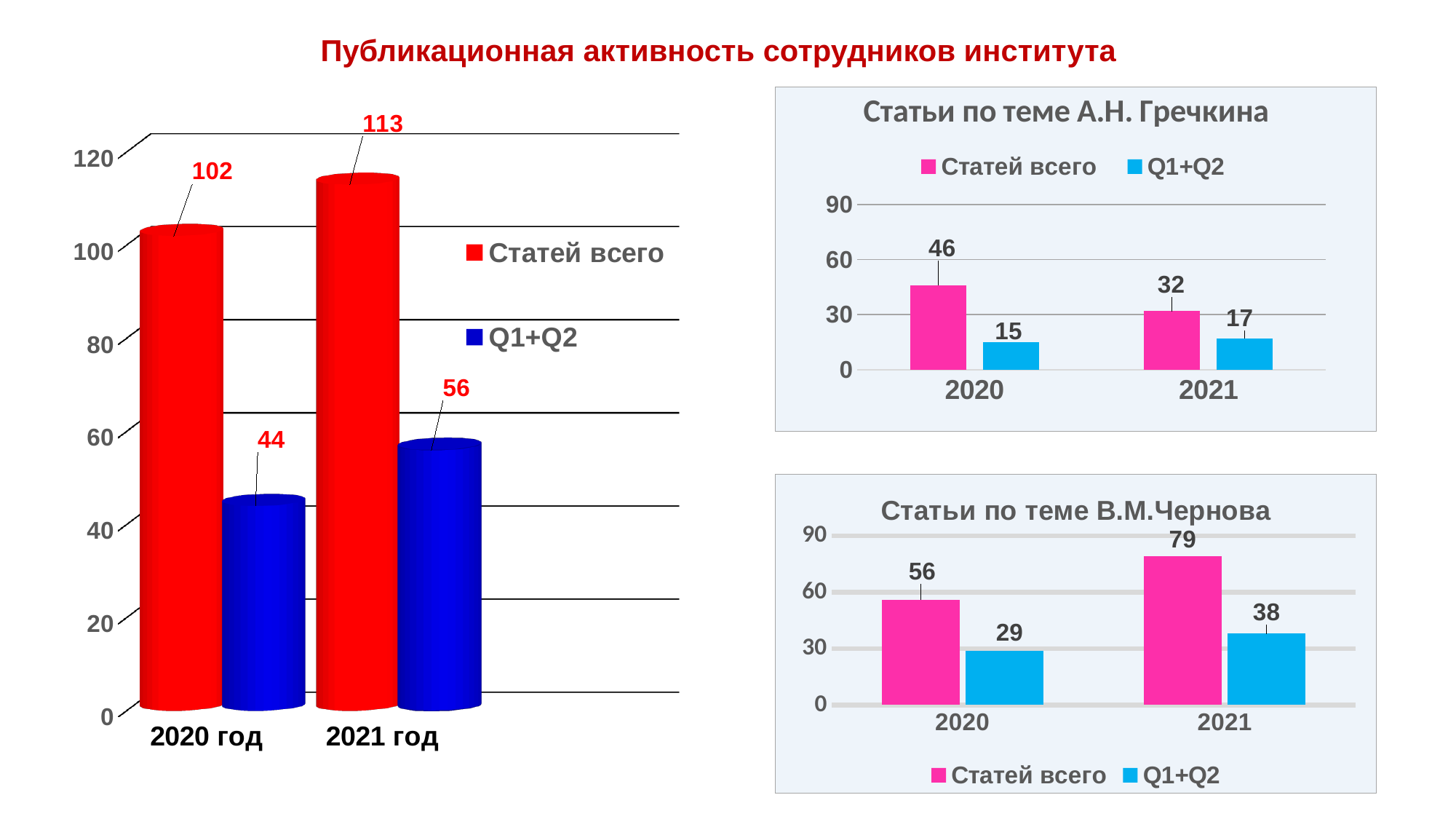
In the chart 'Статьи по теме В.М.Чернова', what is the value of 'Статей всего' for 2021? 79 In the large chart on the left, what is the difference between 'Статей всего' in 2021 год and 2020 год? 11 In the large chart on the left, does the 'Q1+Q2' value rise or fall from 2020 год to 2021 год? rise In the chart 'Статьи по теме В.М.Чернова', what kind of chart is shown? bar chart In the large chart on the left, what is the value of 'Q1+Q2' for 2020 год? 44 In the large chart on the left, how many series does the legend list? 2 In the chart 'Статьи по теме В.М.Чернова', what is the difference between 'Q1+Q2' in 2021 and 2020? 9 In the chart 'Статьи по теме А.Н. Гречкина', what is the value of 'Q1+Q2' for 2021? 17 In the chart 'Статьи по теме А.Н. Гречкина', what is the value of 'Статей всего' for 2020? 46 In the chart 'Статьи по теме А.Н. Гречкина', which year has the higher 'Статей всего' value? 2020 In the large chart on the left, what is the value of 'Статей всего' for 2021 год? 113 In the chart 'Статьи по теме В.М.Чернова', what colour are the 'Q1+Q2' bars? light blue